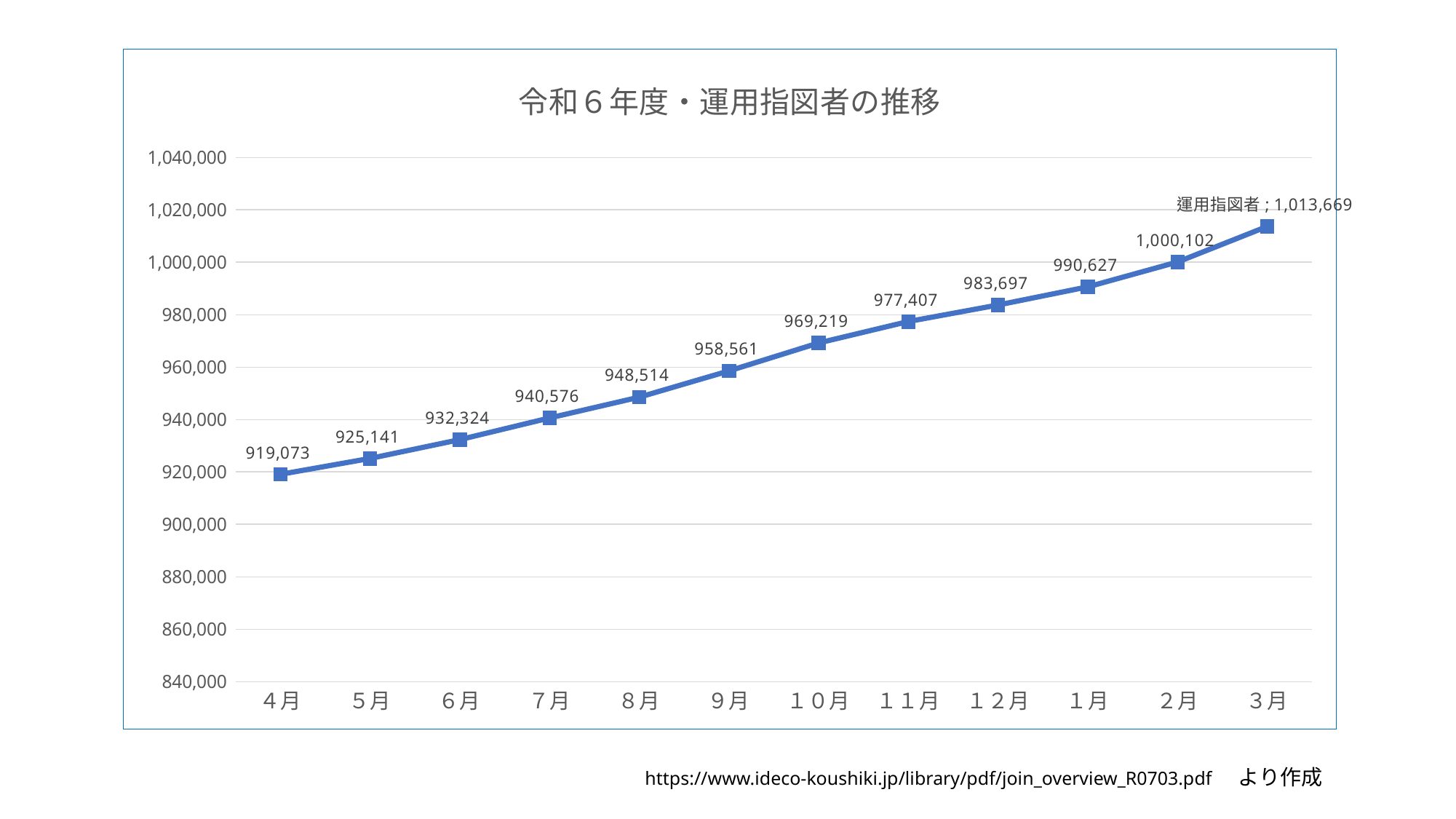
Which is larger, the value for 7月 or the value for 10月? 10月 Which month has the lowest value? 4月 Do the values rise or fall from 4月 to 3月? rise What is the value for 12月? 983,697 What is the difference between the values for 3月 and 4月? 94,596 What is the value for 2月? 1,000,102 What is the difference between the values for 2月 and 1月? 9,475 What is the value for 9月? 958,561 How many data points are plotted on the chart? 12 What type of chart is shown on the slide? line chart What is the value for 4月? 919,073 Which month has the highest value? 3月